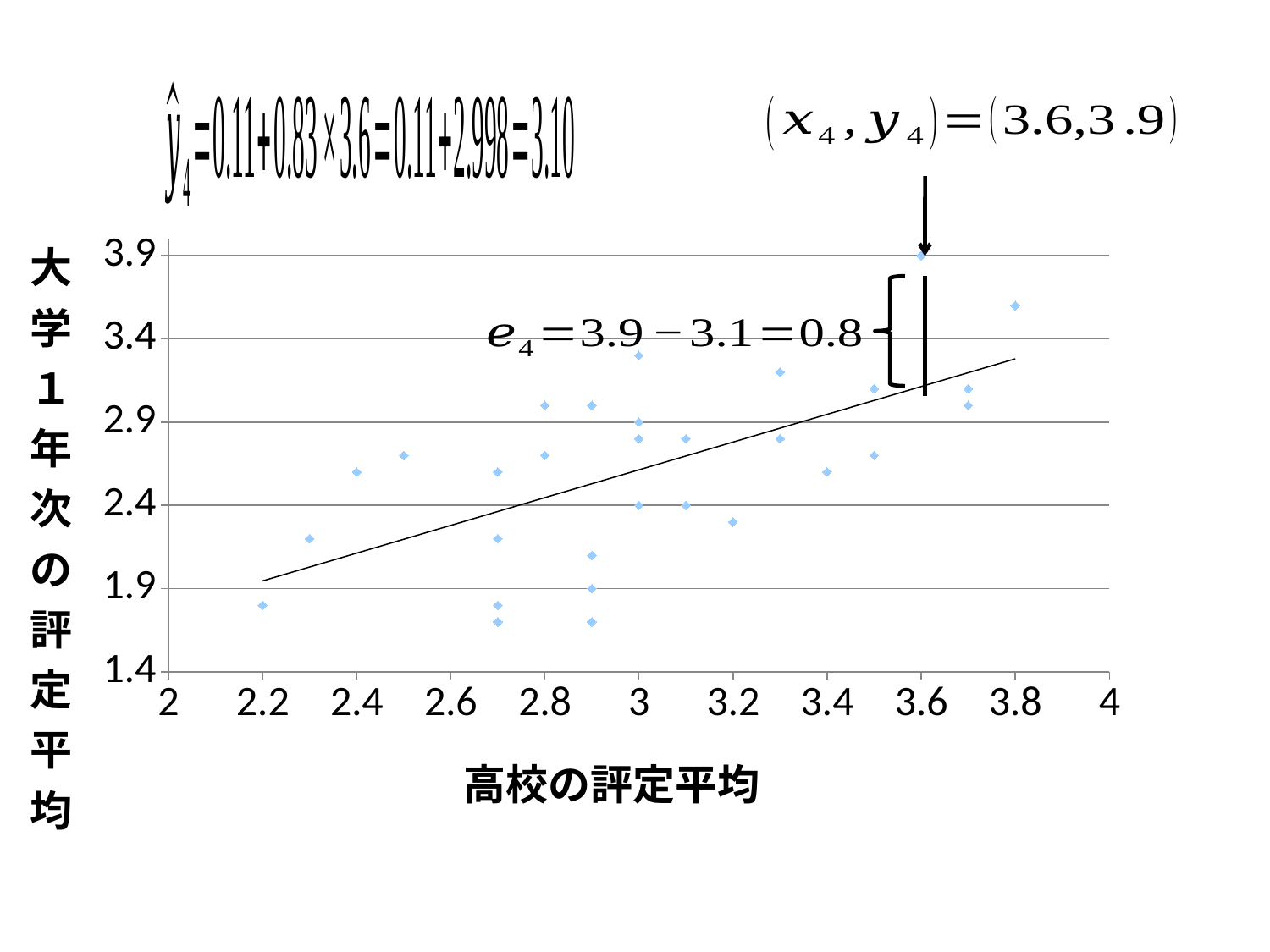
What is the lowest value shown on the y axis of the chart? 1.4 Is the y value of the point at x = 2.2 greater or less than 1.9? less Is the y value of the point at x = 2.3 greater or less than 2.4? less What is the y value of the highest point on the chart? 3.9 Which is larger: the y value of the point at x = 3.6 or the y value of the point at x = 3.8? the point at x = 3.6 Is the y value of the point at x = 3.8 greater or less than 3.4? greater What are the coordinates of the annotated point (x4, y4) on the chart? (3.6, 3.9) What is the label of the y axis of the chart? 大学1年次の評定平均 Do the points on the chart generally rise or fall as the high school GPA increases along the x axis? rise What kind of chart is shown on the slide? scatter plot What is the label of the x axis of the chart? 高校の評定平均 What is the value of the residual e4 shown on the chart? 0.8